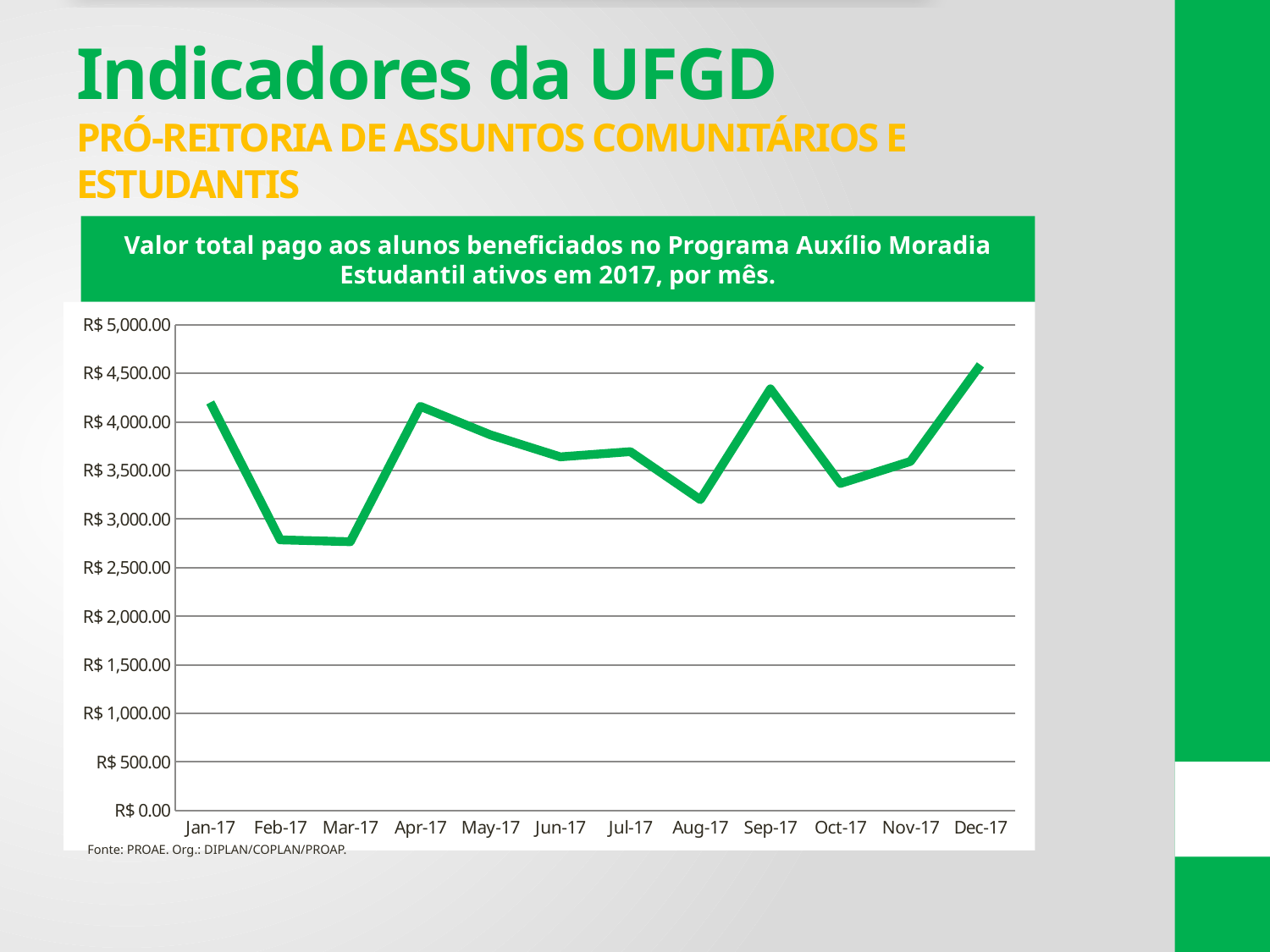
Is the value for Aug-17 greater or less than R$ 3,500.00? less What kind of chart is shown on the slide? line chart Is the value for Oct-17 greater or less than R$ 3,000.00? greater Is the value for Sep-17 greater or less than R$ 4,000.00? greater How many months are plotted along the x axis of the chart? 12 What is the title of the chart? Valor total pago aos alunos beneficiados no Programa Auxílio Moradia Estudantil ativos em 2017, por mês. Which is larger, the value for Sep-17 or the value for Oct-17? Sep-17 Which is larger, the value for Jan-17 or the value for Feb-17? Jan-17 Which month has the highest value in the chart? Dec-17 Do the values rise or fall from Oct-17 to Dec-17? rise